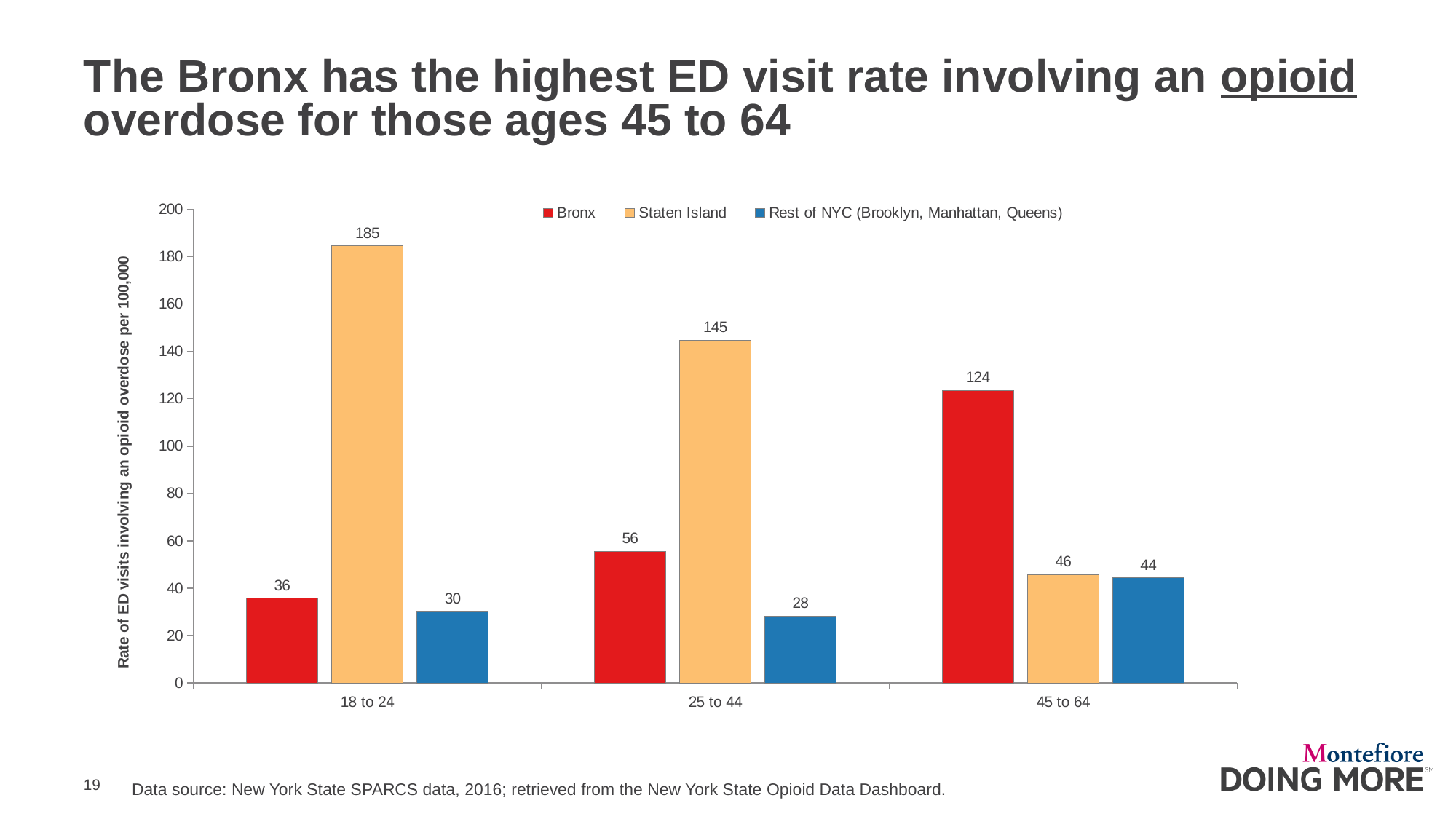
What is the value for Staten Island in the 18 to 24 age group? 185 Do the Bronx values rise or fall as the age groups increase from 18 to 24 to 45 to 64? Rise Which series has the highest value in the 18 to 24 age group? Staten Island What colour are the bars for Staten Island? Orange What is the difference between the Staten Island and Bronx values in the 25 to 44 age group? 89 What is the value for Rest of NYC (Brooklyn, Manhattan, Queens) in the 25 to 44 age group? 28 How many series does the legend list? 3 How many age groups are shown on the x axis? 3 Which series has the lowest value in the 45 to 64 age group? Rest of NYC (Brooklyn, Manhattan, Queens) What is the rate of ED visits involving an opioid overdose for the Bronx in the 45 to 64 age group? 124 What kind of chart is shown on the slide? Bar chart In the 45 to 64 age group, which is larger: the Bronx value or the Staten Island value? Bronx